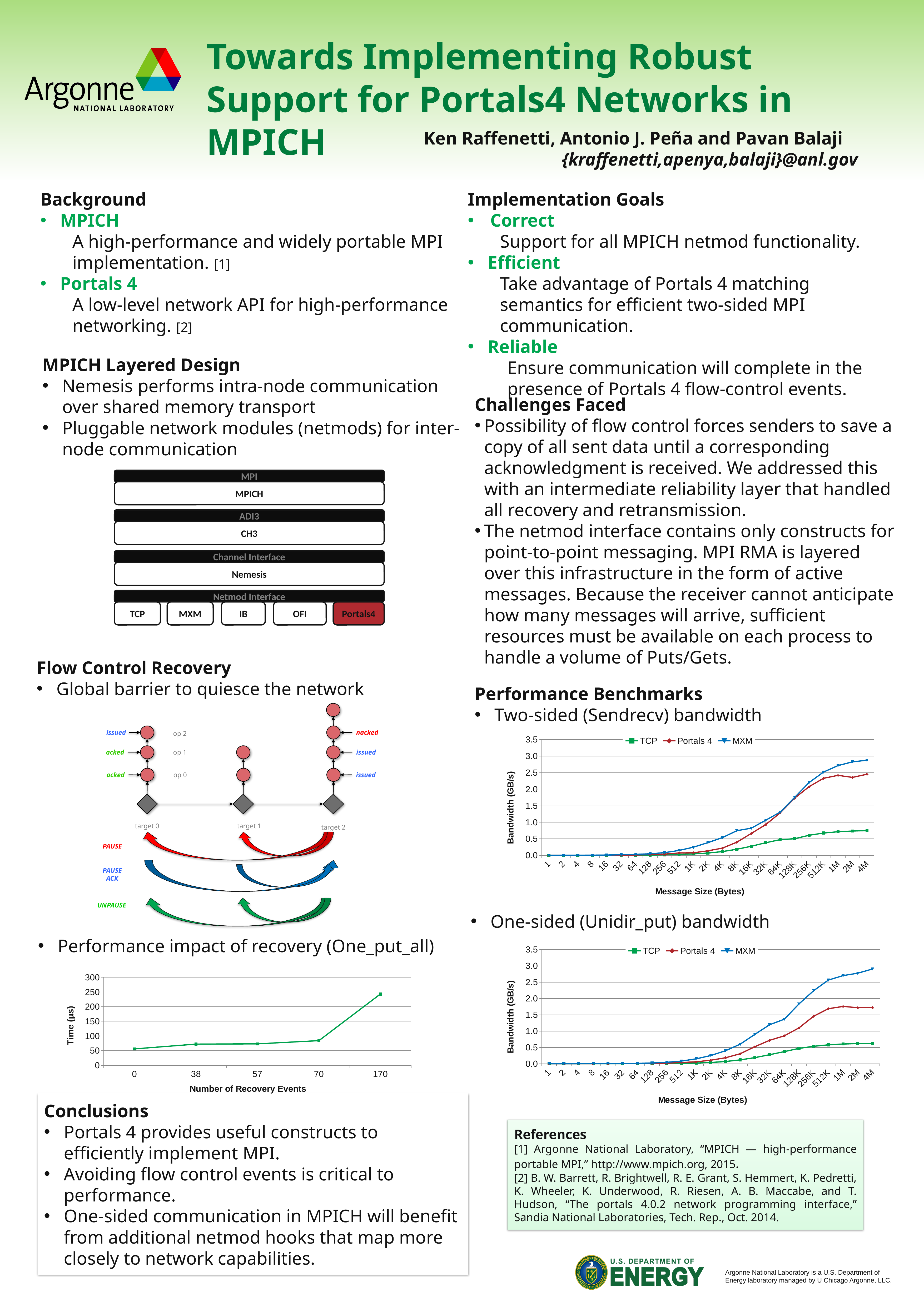
In the 'Two-sided (Sendrecv) bandwidth' chart, is the TCP bandwidth at message size 4M greater or less than 1.0? less In the 'One-sided (Unidir_put) bandwidth' chart, which series has the lowest bandwidth at message size 4M? TCP In the 'Performance impact of recovery (One_put_all)' chart, what kind of chart is shown? line chart In the 'Two-sided (Sendrecv) bandwidth' chart, which series has the highest bandwidth at message size 4M? MXM In the 'Performance impact of recovery (One_put_all)' chart, is the time for 170 recovery events greater or less than 200? greater In the 'One-sided (Unidir_put) bandwidth' chart, is the Portals 4 bandwidth at message size 4M greater or less than 1.5? greater In the 'Performance impact of recovery (One_put_all)' chart, does the time rise or fall as the number of recovery events increases? rise In the 'Two-sided (Sendrecv) bandwidth' chart, how many series does the legend list? 3 In the 'One-sided (Unidir_put) bandwidth' chart, what is the label of the y axis? Bandwidth (GB/s) In the 'Performance impact of recovery (One_put_all)' chart, how many data points are plotted along the x axis? 5 In the 'Performance impact of recovery (One_put_all)' chart, which number of recovery events has the highest time? 170